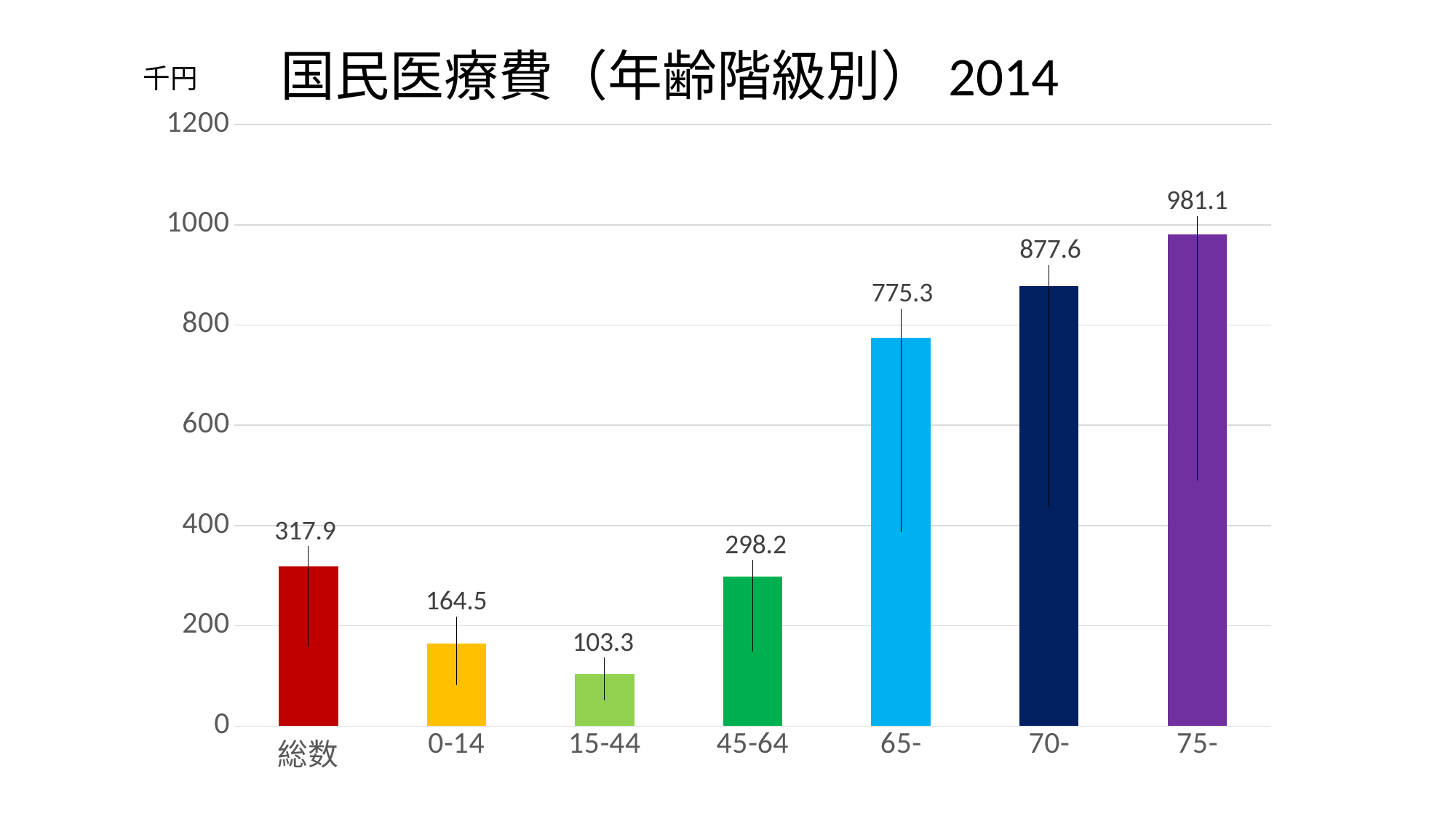
What is the difference between the values for 45-64 and 15-44? 194.9 What kind of chart is shown on the slide? bar chart What unit is shown at the top of the vertical axis? 千円 Which age group has the lowest value? 15-44 Is the value for 70- greater or less than 800? greater What is the value for the 0-14 age group? 164.5 Which age group has the highest value? 75- How many categories are shown on the x axis? 7 Which is larger, the value for 65- or the value for 45-64? 65- What is the value for the 75- age group? 981.1 What is the value for 総数 (total)? 317.9 What is the difference between the values for 75- and 70-? 103.5